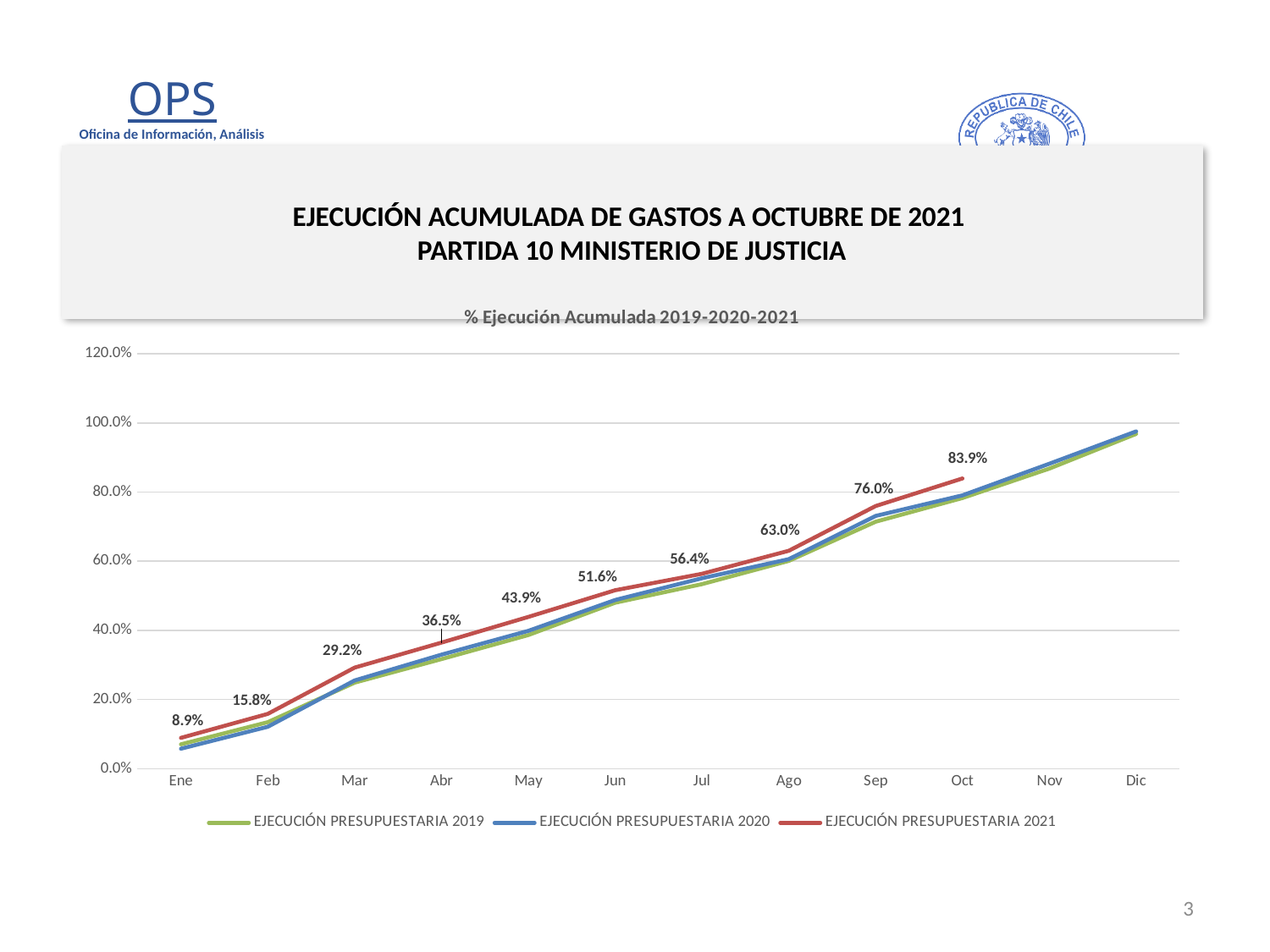
What is the difference between the EJECUCIÓN PRESUPUESTARIA 2021 values for Sep and Ago? 13.0% How many months are shown on the x axis? 12 Is the value for EJECUCIÓN PRESUPUESTARIA 2020 in Dic greater or less than 80.0%? greater How many series does the legend list? 3 What is the value for EJECUCIÓN PRESUPUESTARIA 2021 in Jun? 51.6% What is the title of the chart? % Ejecución Acumulada 2019-2020-2021 What is the value for EJECUCIÓN PRESUPUESTARIA 2021 in Ene? 8.9% What type of chart is shown on the slide? line chart What is the value for EJECUCIÓN PRESUPUESTARIA 2021 in Oct? 83.9% Which month has the highest labelled value for EJECUCIÓN PRESUPUESTARIA 2021? Oct What is the difference between the EJECUCIÓN PRESUPUESTARIA 2021 values for Oct and Ene? 75.0% Do the values for EJECUCIÓN PRESUPUESTARIA 2021 rise or fall from Ene to Oct? rise